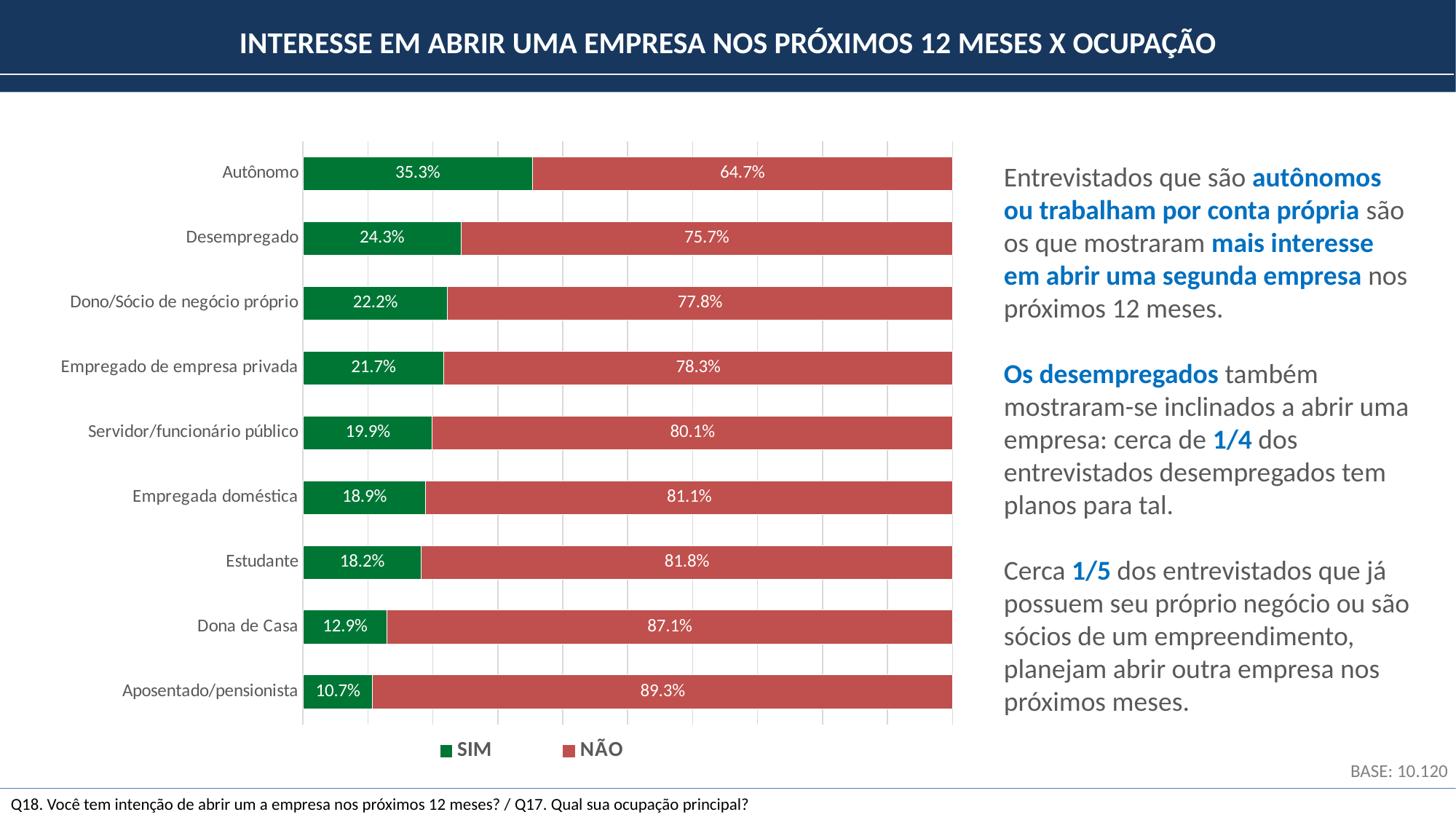
What is the SIM value for Servidor/funcionário público? 19.9% What kind of chart is shown on the slide? Stacked bar chart How many occupation categories are shown in the chart? 9 What is the difference between the SIM values for Autônomo and Desempregado? 11.0% What is the SIM value for Autônomo? 35.3% How many series does the legend list? 2 Which has a larger SIM value, Estudante or Empregada doméstica? Empregada doméstica What is the NÃO value for Dona de Casa? 87.1% Which occupation has the highest SIM value? Autônomo Which occupation has the lowest SIM value? Aposentado/pensionista What is the total of the SIM and NÃO values for Dono/Sócio de negócio próprio? 100.0% Which colour represents the NÃO series in the chart? Red